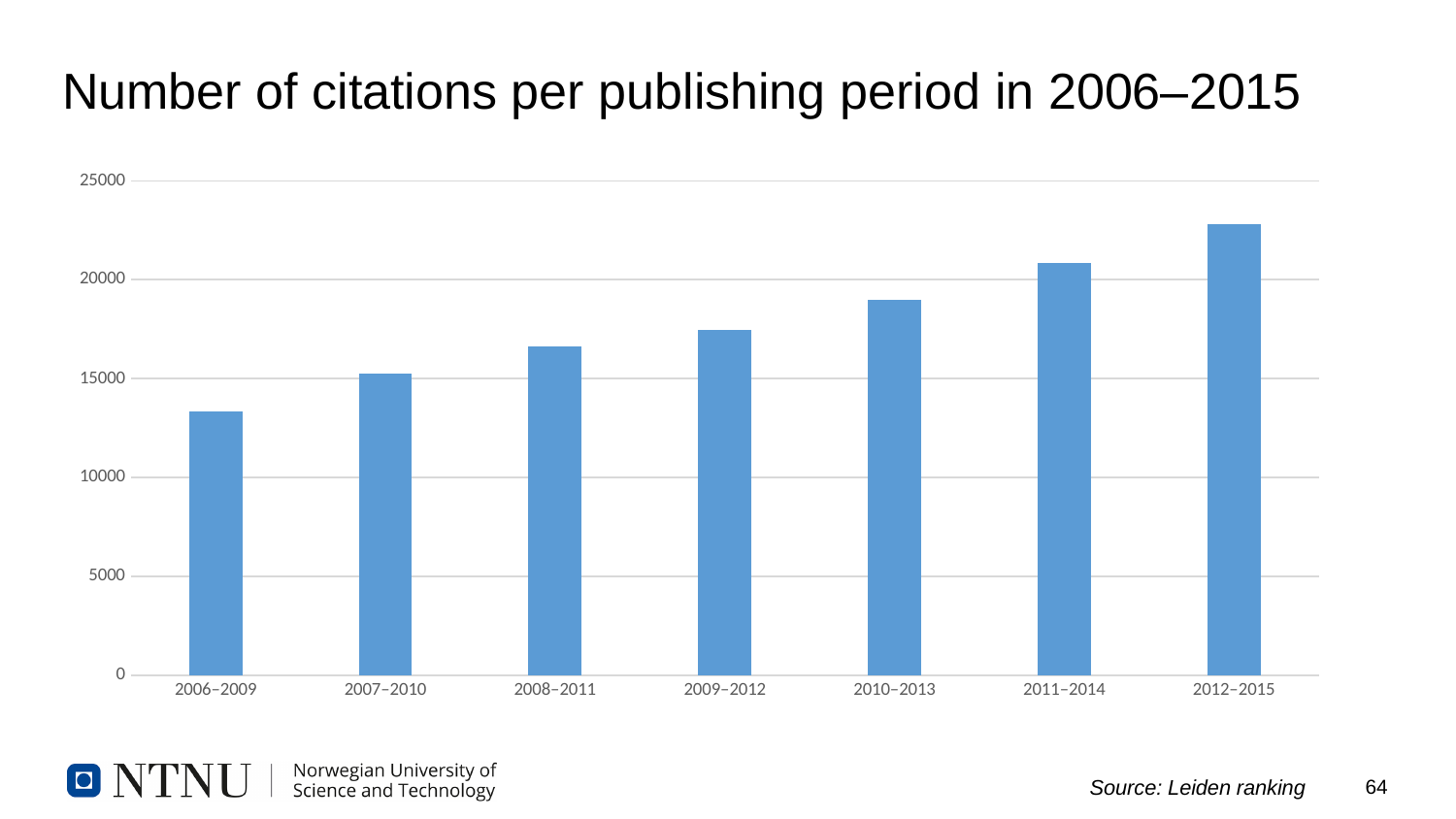
Which publishing period has the lowest number of citations? 2006–2009 Do the number of citations rise or fall across the publishing periods from 2006–2009 to 2012–2015? Rise Is the value for 2006–2009 greater or less than 15000? less Is the value for 2010–2013 greater or less than 20000? less What source is cited for the chart data? Leiden ranking How many publishing periods are shown on the x axis? 7 Is the value for 2008–2011 greater or less than 15000? greater Which has more citations, 2010–2013 or 2008–2011? 2010–2013 What is the title of the chart? Number of citations per publishing period in 2006–2015 Which publishing period has the highest number of citations? 2012–2015 What kind of chart is shown on the slide? Bar chart